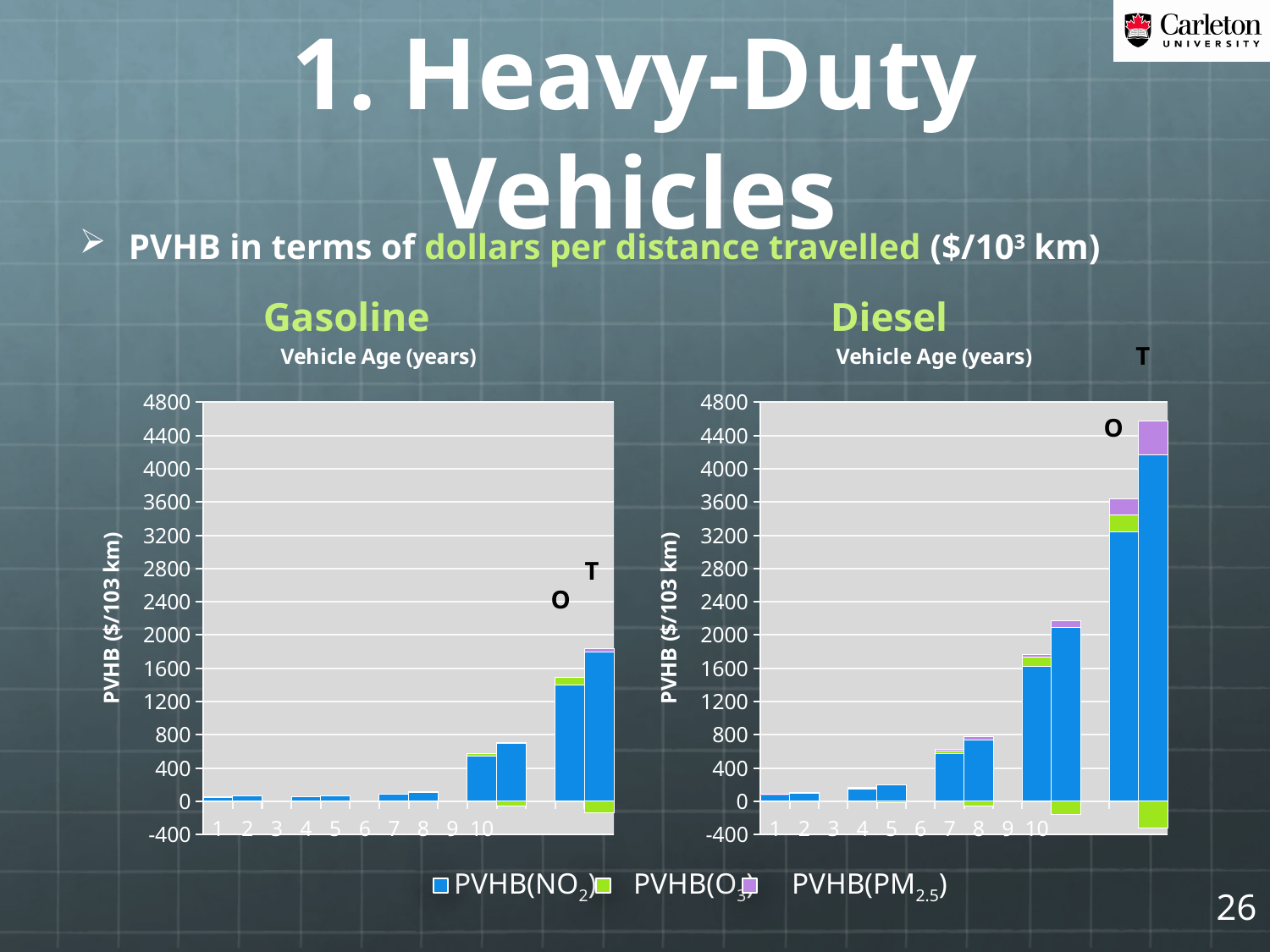
How many series does the legend list for the charts? 3 What are the three series named in the legend? PVHB(NO2), PVHB(O3), PVHB(PM2.5) Which chart, Gasoline or Diesel, has the taller maximum bar? Diesel What kind of chart is the Gasoline chart? Stacked bar chart What is the highest value shown on the y-axis of the Gasoline chart? 4800 In the Diesel chart, is the top of the tallest bar greater or less than 4800? less In the Diesel chart, is the top of the tallest bar greater or less than 4000? greater Which series makes up the largest portion of the tallest bar in the Diesel chart? PVHB(NO2) In the Diesel chart, do the bar heights generally rise or fall as vehicle age increases from left to right? rise In the Gasoline chart, do the bar heights generally rise or fall as vehicle age increases from left to right? rise In the Gasoline chart, is the top of the tallest bar greater or less than 2000? less What is the y-axis title of the Diesel chart? PVHB ($/103 km)